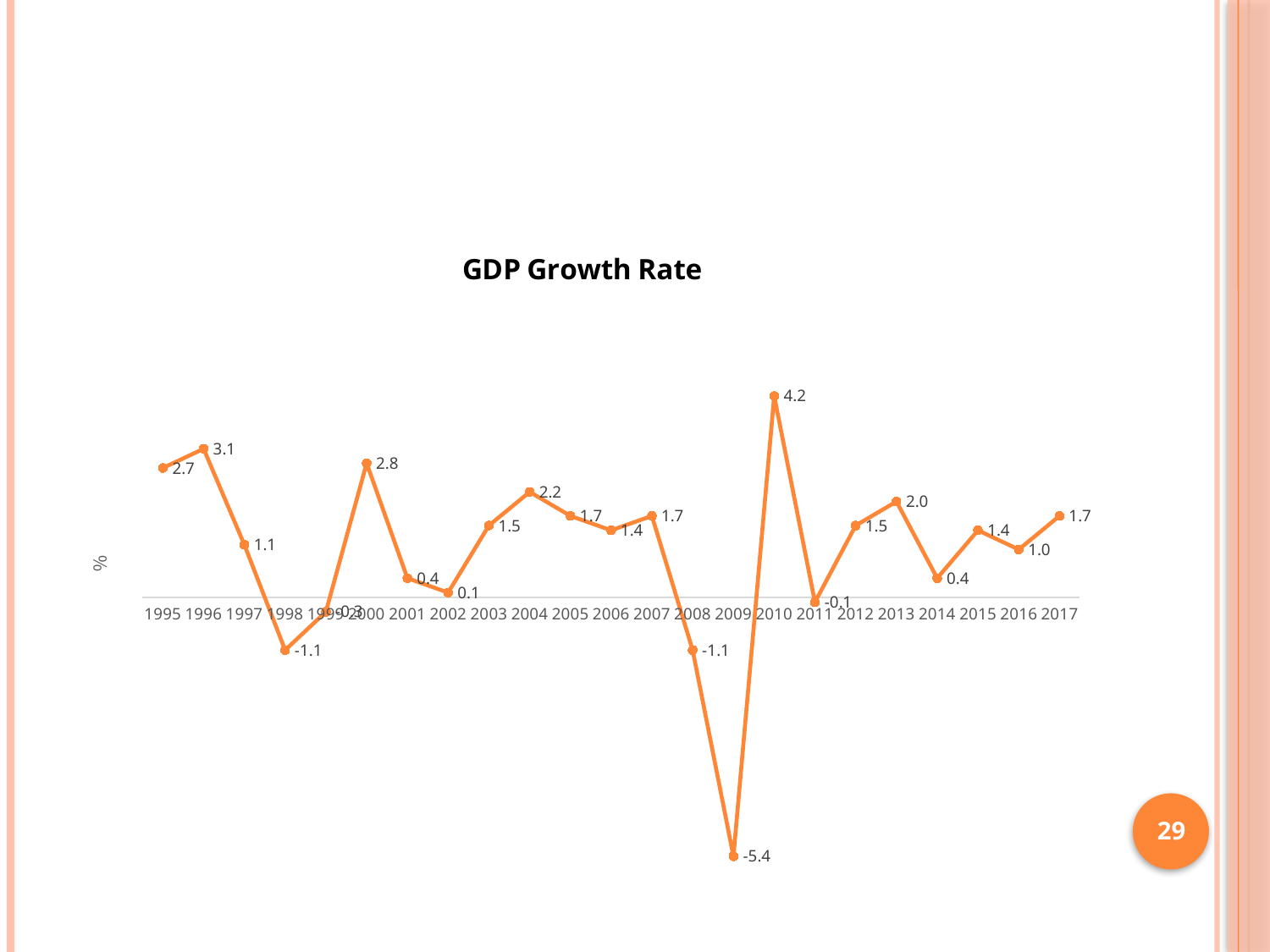
What is the title of the chart? GDP Growth Rate How many years are plotted on the GDP Growth Rate chart? 23 What is the difference between the GDP growth rate in 2000 and in 2001? 2.4 What type of chart is used to show the GDP Growth Rate? Line chart What is the GDP growth rate shown for 2017? 1.7 Which year has a higher GDP growth rate, 2013 or 2014? 2013 Which year has the lowest GDP growth rate on the chart? 2009 What is the GDP growth rate shown for 1996? 3.1 Which year has the highest GDP growth rate on the chart? 2010 What is the GDP growth rate shown for 2010? 4.2 What is the GDP growth rate shown for 2009? -5.4 What is the difference between the GDP growth rate in 2010 and in 2009? 9.6